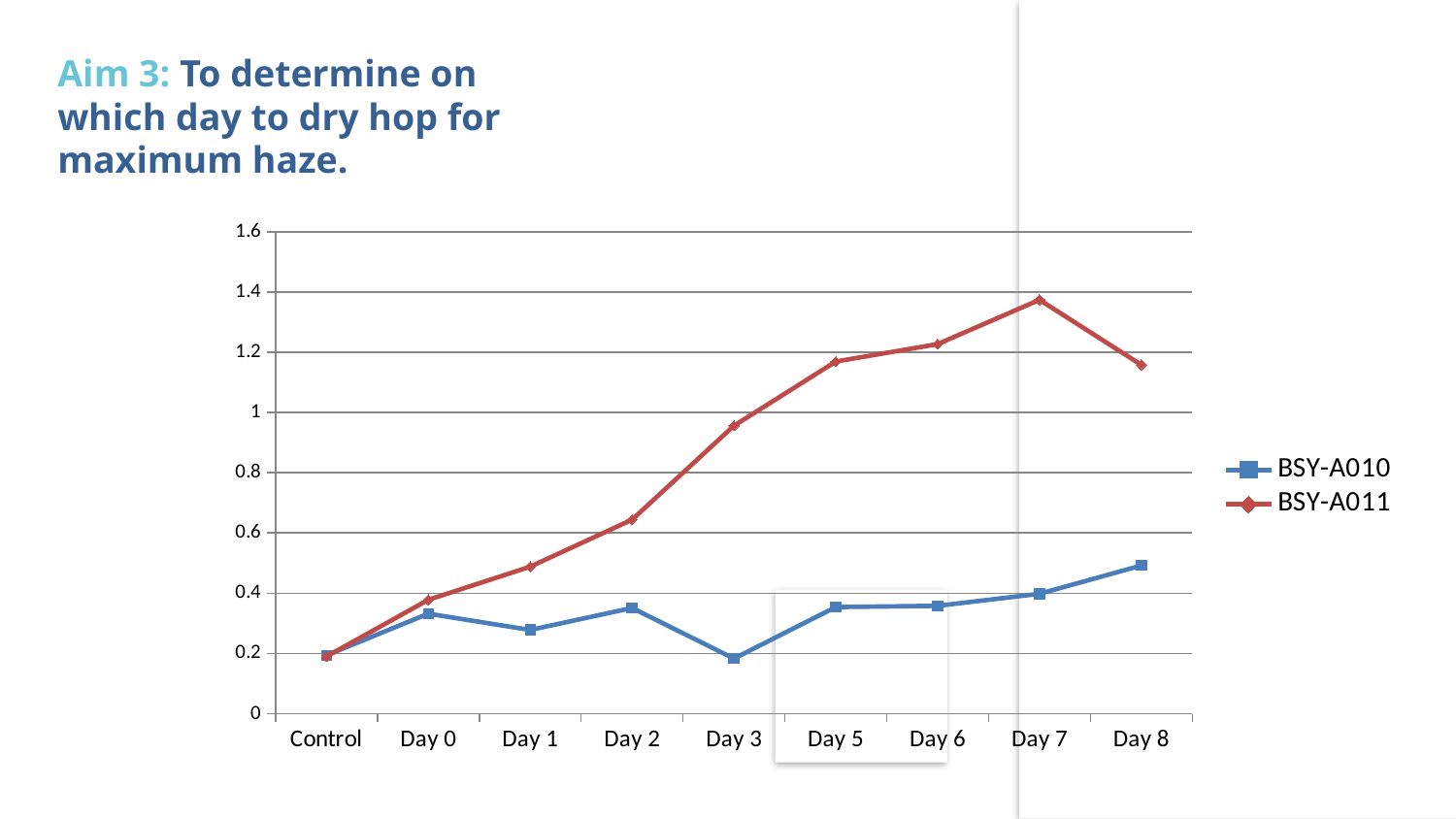
Is the value for BSY-A011 at Day 7 greater or less than 1.2? greater Does the BSY-A011 series rise or fall from Control to Day 7? Rise At which x-axis category does BSY-A011 reach its highest value? Day 7 What colour is the line for BSY-A011 in the legend? Red What kind of chart is shown on the slide? Line chart Does the BSY-A011 series rise or fall from Day 7 to Day 8? Fall At Day 5, which series has the higher value, BSY-A010 or BSY-A011? BSY-A011 Is the value for BSY-A011 at Day 2 greater or less than 0.8? less Is the value for BSY-A010 at Day 8 greater or less than 0.4? greater How many series does the legend list? 2 At which x-axis category does BSY-A010 reach its highest value? Day 8 How many categories are shown along the x axis? 9